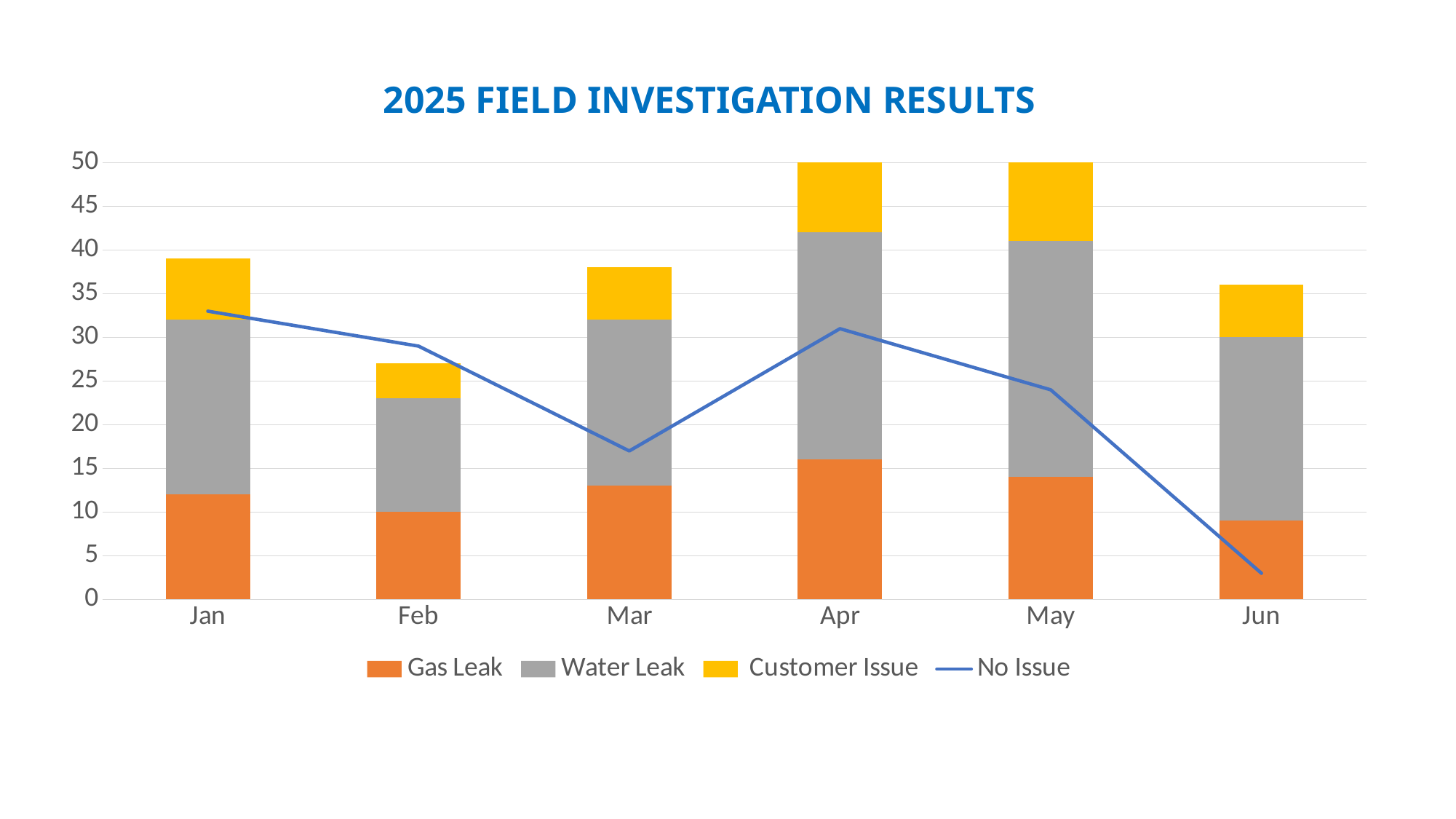
What is the Gas Leak value for Feb? 10 What is the title of the chart? 2025 FIELD INVESTIGATION RESULTS Is the No Issue value for Mar greater or less than 20? less Which is larger, the stacked bar total for Jan or for Feb? Jan Which month has the lowest No Issue value? Jun How many months are shown on the x axis? 6 What is the total height of the stacked bar for May? 50 Which month has the lowest stacked bar total? Feb Is the Gas Leak value for Jan greater or less than 10? greater Does the No Issue line rise or fall from May to Jun? fall How many series does the legend list? 4